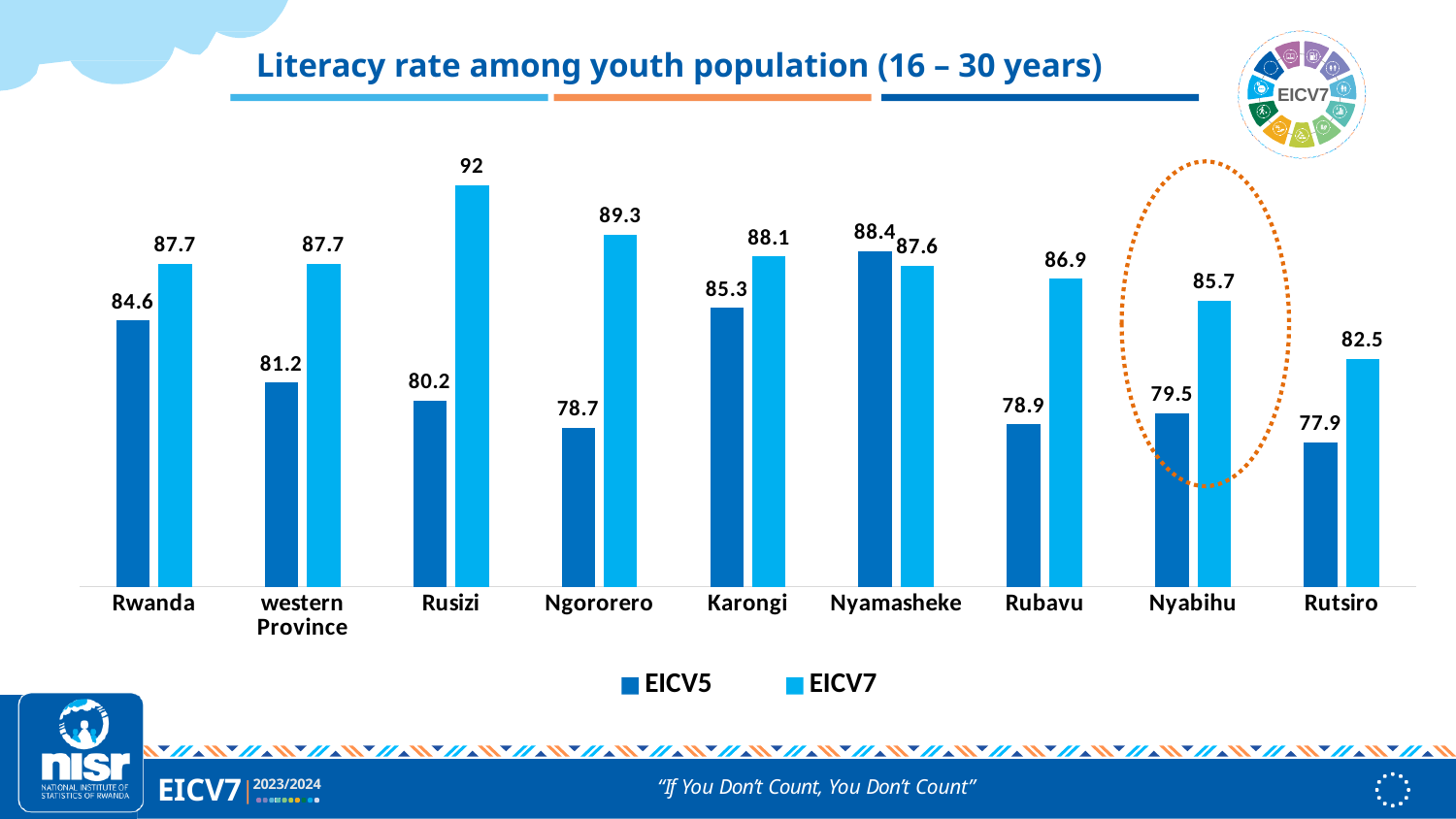
Which category has the highest EICV5 literacy rate? Nyamasheke Which district or area has the highest EICV7 literacy rate? Rusizi Which category has the lowest EICV5 literacy rate? Rutsiro What is the EICV7 literacy rate for Rusizi? 92 What is the EICV5 literacy rate for Nyabihu? 79.5 How many series does the legend list? 2 What type of chart is shown on the slide? Bar chart What is the EICV7 value for Rutsiro? 82.5 How many categories are shown on the x axis? 9 What is the difference between the EICV7 and EICV5 values for Nyabihu? 6.2 What is the difference between the EICV7 and EICV5 values for Rusizi? 11.8 For Nyamasheke, which is larger: the EICV5 value or the EICV7 value? EICV5